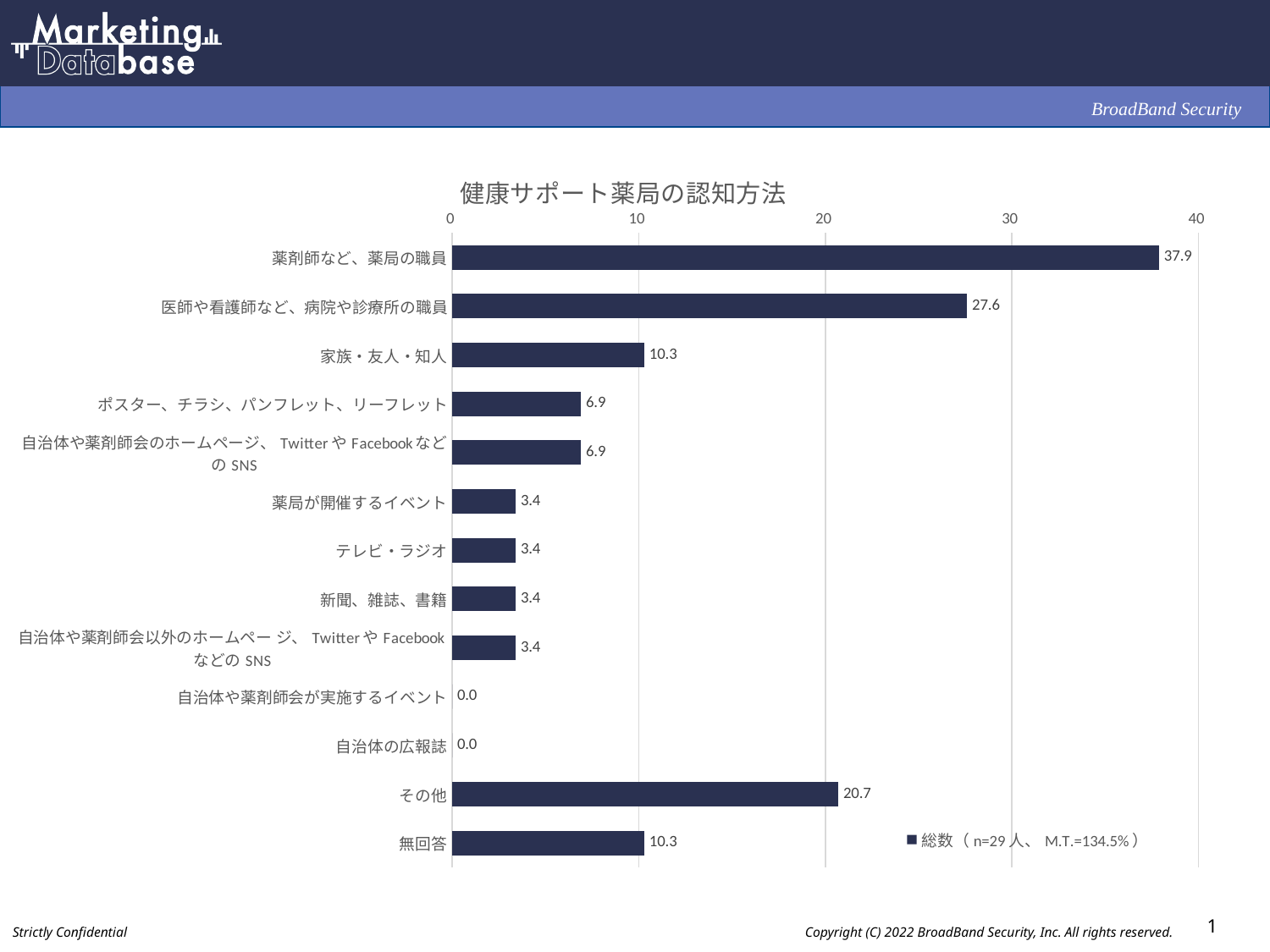
How many categories are shown in the chart? 13 Which is larger, the value for その他 or the value for 家族・友人・知人? その他 What is the value for 無回答? 10.3 What is the value for 薬剤師など、薬局の職員? 37.9 Which category has the highest value? 薬剤師など、薬局の職員 What is the value for 家族・友人・知人? 10.3 What kind of chart is shown on the slide? Bar chart Is the value for 医師や看護師など、病院や診療所の職員 greater or less than 20? greater What is the difference between the values for 薬剤師など、薬局の職員 and 医師や看護師など、病院や診療所の職員? 10.3 What is the value for 医師や看護師など、病院や診療所の職員? 27.6 What is the value for その他? 20.7 What is the title of the chart? 健康サポート薬局の認知方法